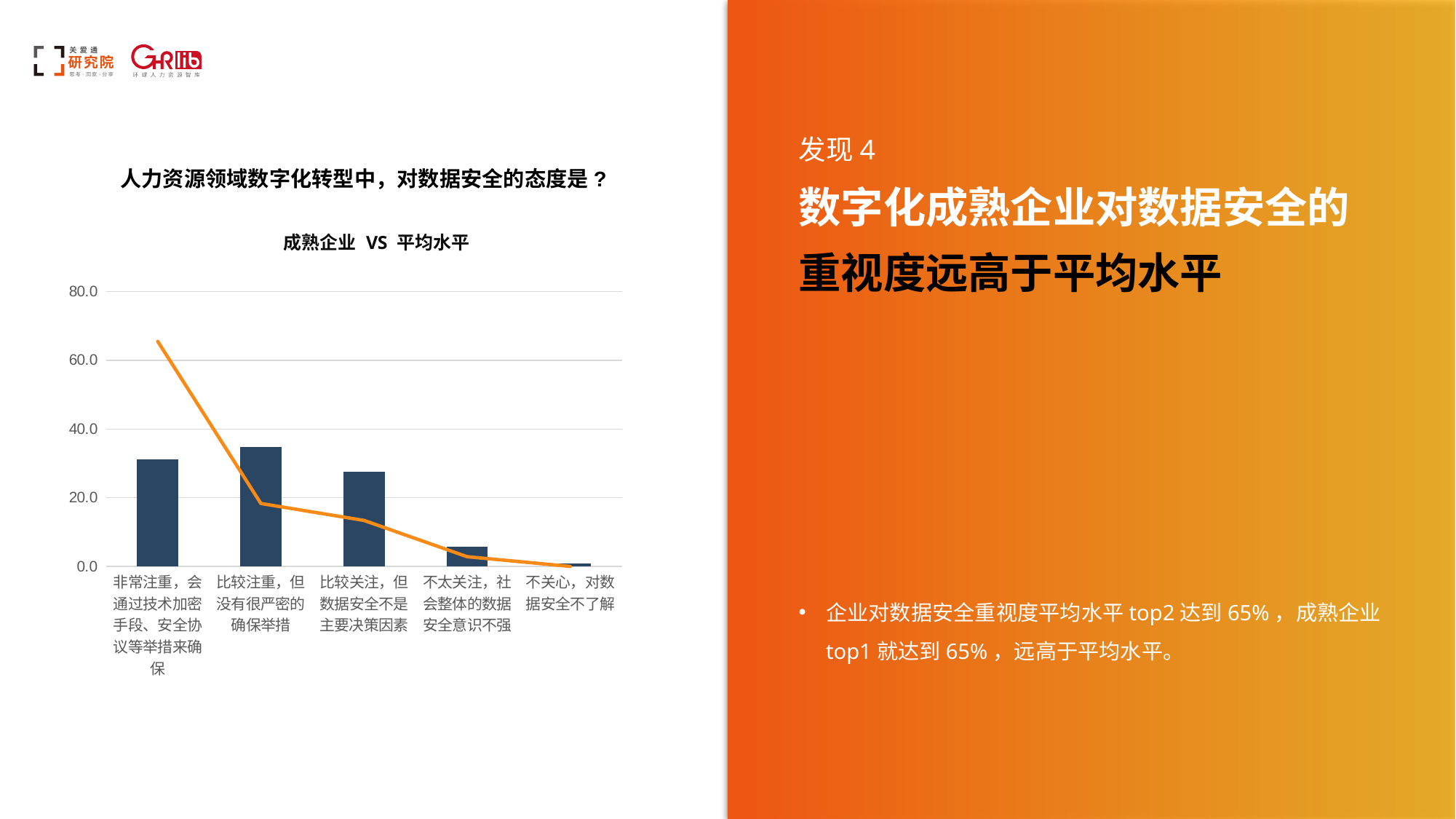
What is the subtitle of the chart, shown just above the plot area? 成熟企业 VS 平均水平 Is the bar value for the category 非常注重，会通过技术加密手段、安全协议等举措来确保 greater or less than 40.0? less For the category 比较注重，但没有很严密的确保举措, which is higher: the bar or the orange line? The bar Which category has the tallest bar? 比较注重，但没有很严密的确保举措 Is the value of the orange line for the category 非常注重，会通过技术加密手段、安全协议等举措来确保 greater or less than 60.0? greater Is the bar value for the category 不太关注，社会整体的数据安全意识不强 greater or less than 20.0? less What kind of chart is shown on the slide? A bar chart combined with a line For the category 非常注重，会通过技术加密手段、安全协议等举措来确保, which is higher: the bar or the orange line? The orange line How many categories are shown on the x axis of the chart? 5 Does the orange line rise or fall from left to right across the categories? Fall Which category has the shortest bar? 不关心，对数据安全不了解